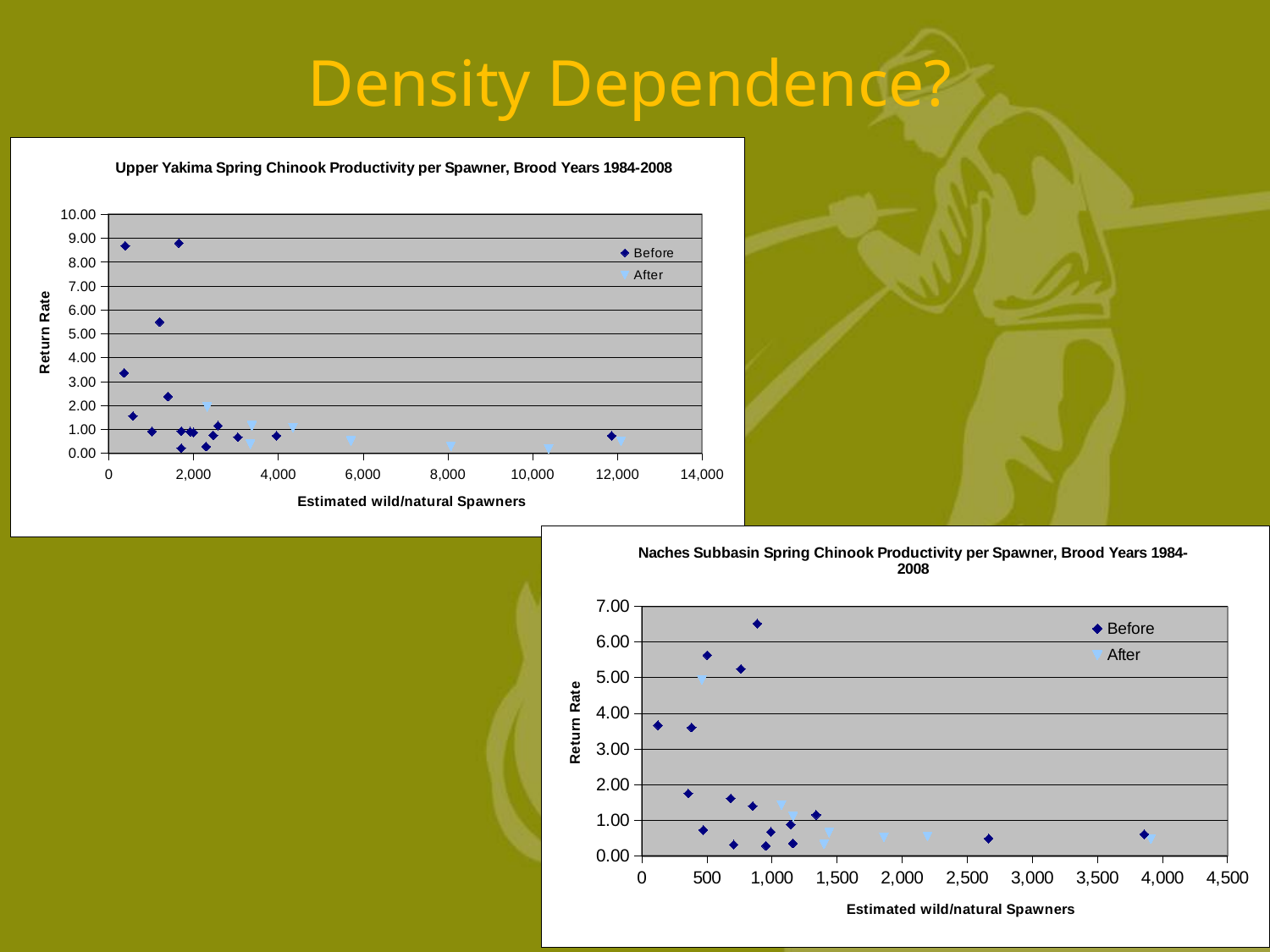
In the Upper Yakima chart, what are the two series named in the legend? Before and After How many series does the legend of the Naches Subbasin chart list? 2 In the Upper Yakima chart, are the return rates for the points near 12,000 spawners greater or less than 1.00? less In the Upper Yakima chart, do return rates generally rise or fall as the number of estimated wild/natural spawners increases? fall In the Upper Yakima chart, is the highest 'Before' return rate greater or less than 8.00? greater How many series does the legend of the Upper Yakima chart list? 2 In the Naches Subbasin chart, is the return rate for the 'Before' point near 2,700 spawners greater or less than 1.00? less What kind of chart is the top-left chart titled 'Upper Yakima Spring Chinook Productivity per Spawner, Brood Years 1984-2008'? Scatter chart In the Naches Subbasin chart, do return rates generally rise or fall as the number of estimated wild/natural spawners increases? fall What kind of chart is the bottom-right chart titled 'Naches Subbasin Spring Chinook Productivity per Spawner, Brood Years 1984-2008'? Scatter chart What is the y-axis label of the Naches Subbasin chart? Return Rate